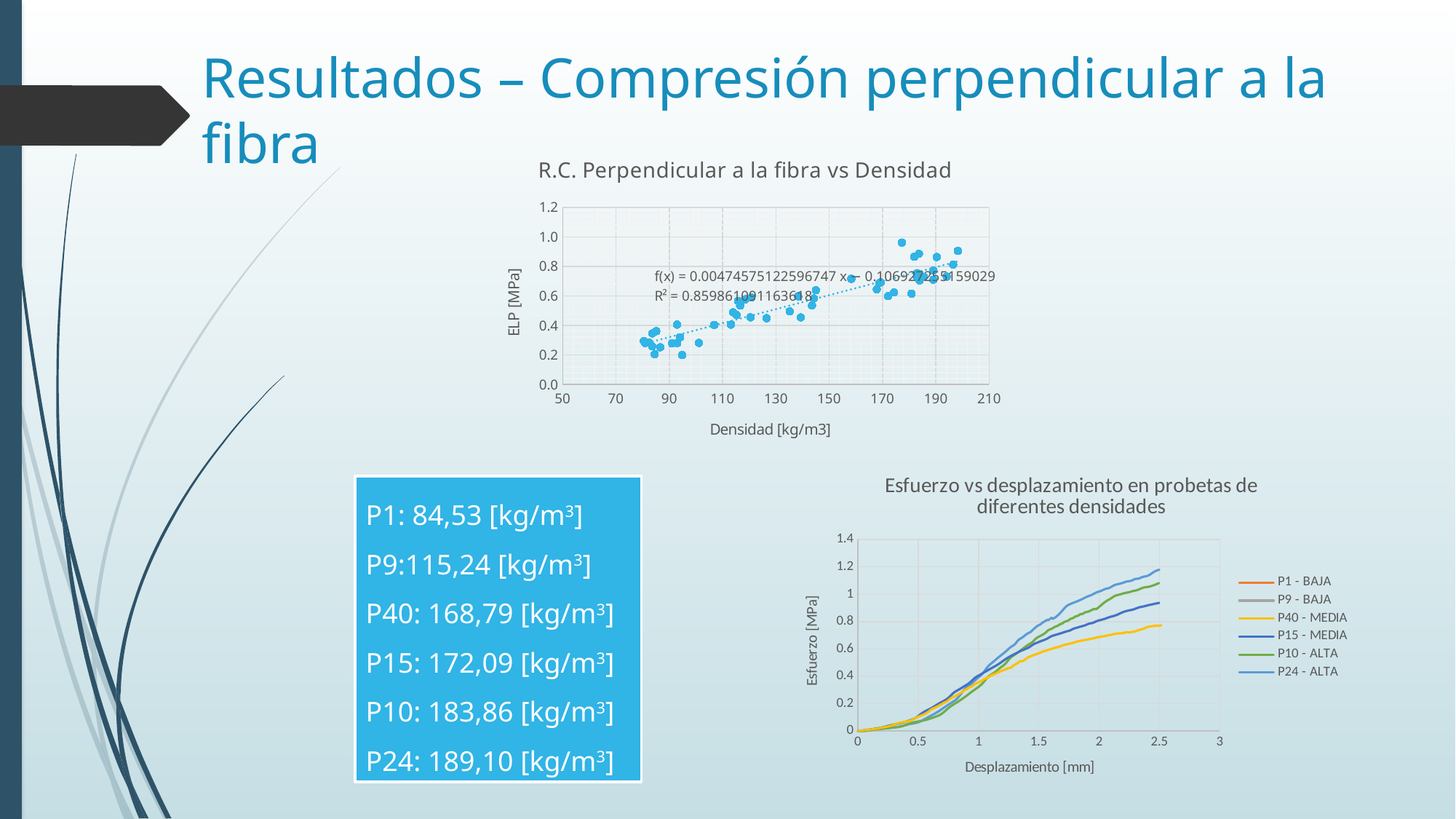
In the bottom chart "Esfuerzo vs desplazamiento en probetas de diferentes densidades", is the value for P15 - MEDIA at 2.5 mm greater or less than 1? less What is the x-axis label of the top chart "R.C. Perpendicular a la fibra vs Densidad"? Densidad [kg/m3] In the bottom chart "Esfuerzo vs desplazamiento en probetas de diferentes densidades", do the Esfuerzo values rise or fall as displacement increases? rise In the top chart "R.C. Perpendicular a la fibra vs Densidad", do the ELP values rise or fall as density increases? rise What kind of chart is the top chart titled "R.C. Perpendicular a la fibra vs Densidad"? scatter chart How many series does the legend of the bottom chart "Esfuerzo vs desplazamiento en probetas de diferentes densidades" list? 6 In the bottom chart "Esfuerzo vs desplazamiento en probetas de diferentes densidades", which series is higher at 2.5 mm, P24 - ALTA or P40 - MEDIA? P24 - ALTA In the bottom chart "Esfuerzo vs desplazamiento en probetas de diferentes densidades", is the value for P24 - ALTA at 2.5 mm greater or less than 1? greater In the bottom chart "Esfuerzo vs desplazamiento en probetas de diferentes densidades", which series reaches the highest Esfuerzo value? P24 - ALTA What R² value is printed on the top chart "R.C. Perpendicular a la fibra vs Densidad"? R² = 0.859861091163618 In the bottom chart "Esfuerzo vs desplazamiento en probetas de diferentes densidades", which of the visible series ends at the lowest Esfuerzo value at 2.5 mm? P40 - MEDIA What kind of chart is the bottom chart titled "Esfuerzo vs desplazamiento en probetas de diferentes densidades"? line chart